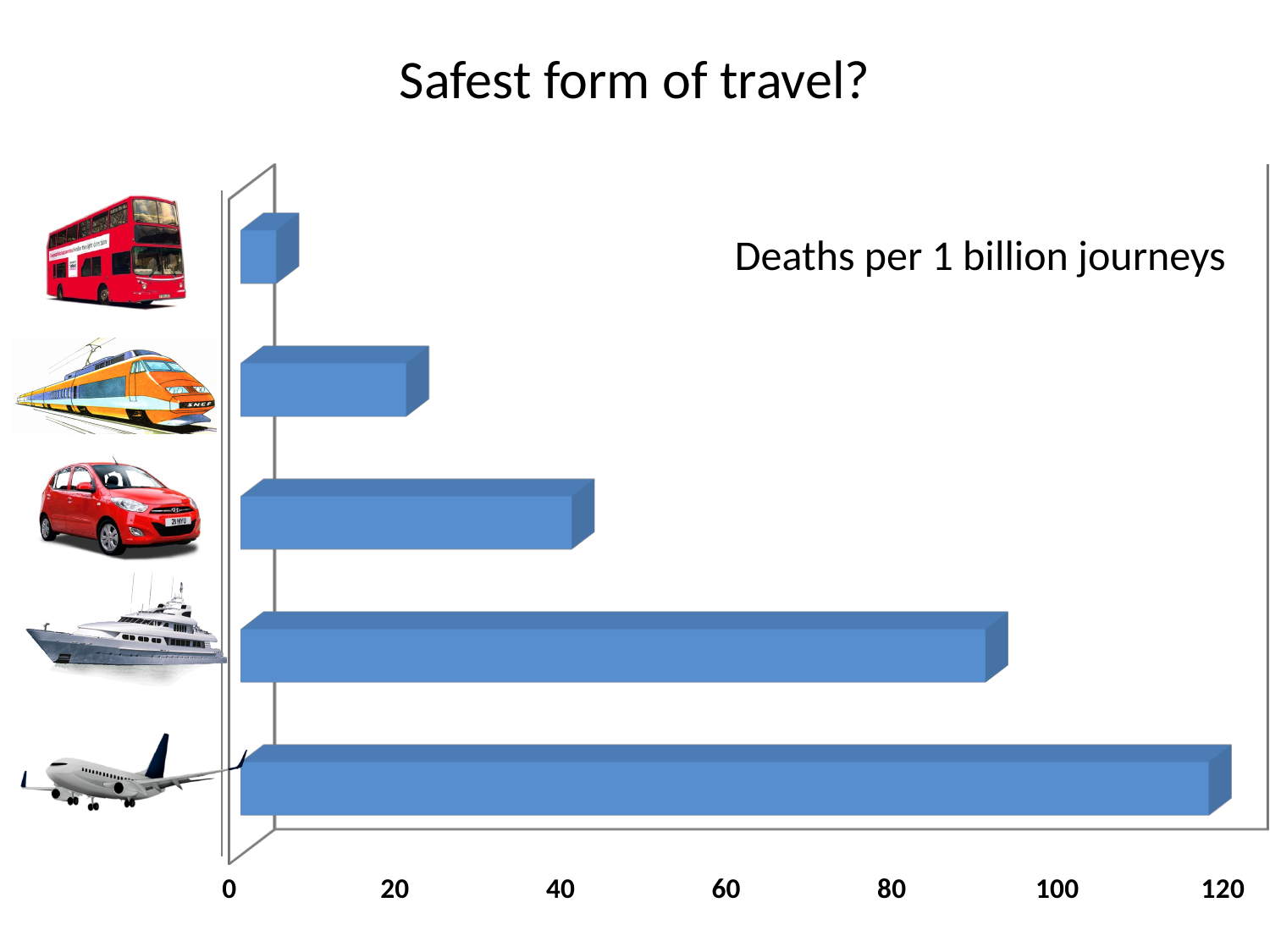
Is the value for the boat greater or less than 80? greater Is the value for the train greater or less than 40? less What quantity does the chart measure, according to the text on the slide? Deaths per 1 billion journeys Which has a larger value in the chart, the boat or the car? boat Which form of travel has the lowest number of deaths per 1 billion journeys in the chart? bus Is the value for the bus greater or less than 20? less What kind of chart is shown on the slide? bar chart What is the title of the slide containing the chart? Safest form of travel? How many forms of travel (bars) are plotted in the chart? 5 Which form of travel has the highest number of deaths per 1 billion journeys in the chart? airplane